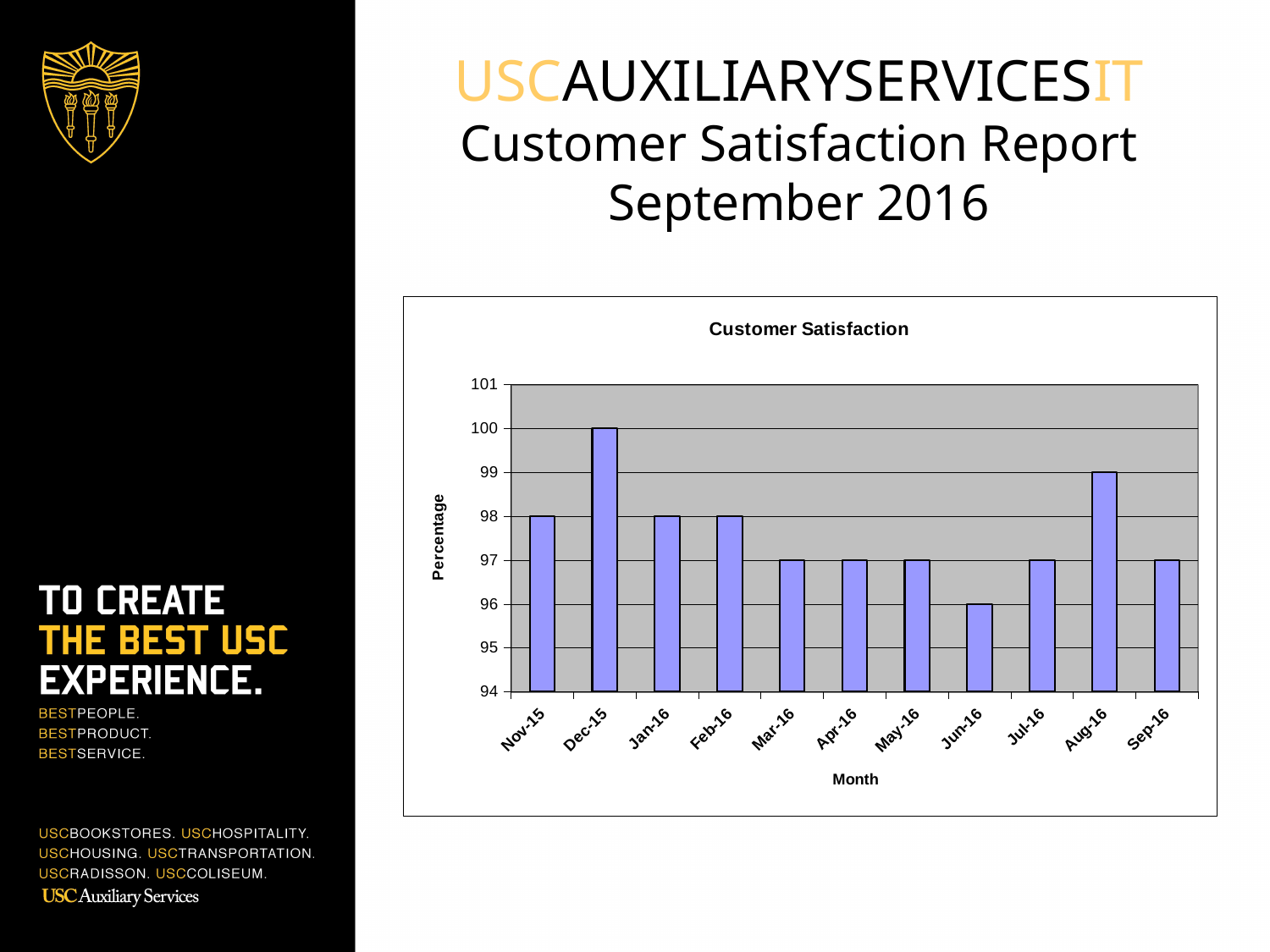
What is the title of the chart? Customer Satisfaction What is the difference between the customer satisfaction percentage for Dec-15 and Jun-16? 4 Which month has the lowest customer satisfaction percentage? Jun-16 What is the label of the y axis of the chart? Percentage Which month has a higher customer satisfaction percentage, Nov-15 or Mar-16? Nov-15 How many months are plotted on the x axis of the chart? 11 What is the customer satisfaction percentage for Jun-16? 96 What is the customer satisfaction percentage for Sep-16? 97 What is the customer satisfaction percentage for Aug-16? 99 Which month has the highest customer satisfaction percentage? Dec-15 What is the customer satisfaction percentage for Dec-15? 100 What kind of chart is shown on the slide? bar chart